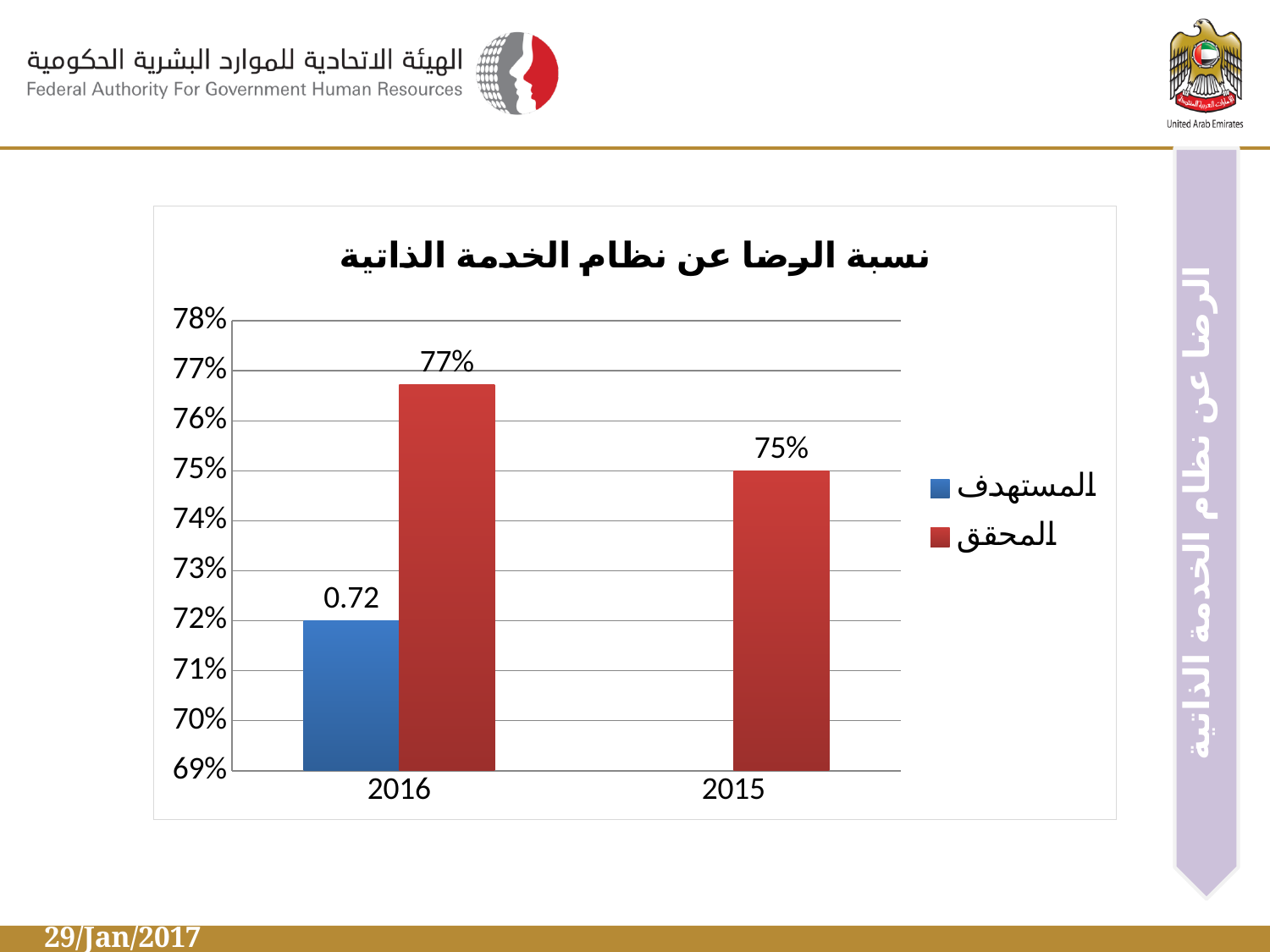
What is the value of the المحقق (achieved) bar for 2016? 77% How many years are shown on the x axis? 2 What is the title of the chart? نسبة الرضا عن نظام الخدمة الذاتية What kind of chart is shown on the slide? bar chart What is the difference between the المحقق (achieved) values for 2016 and 2015? 2% Which year has the higher المحقق (achieved) value? 2016 How many series does the legend list? 2 Is the المستهدف (target) value for 2016 greater or less than 73%? less For 2016, which is larger: the المستهدف (target) bar or the المحقق (achieved) bar? المحقق (achieved) What data label is shown on the المستهدف (target) bar for 2016? 0.72 Which colour represents the المحقق (achieved) series in the legend? red What is the value of the المحقق (achieved) bar for 2015? 75%